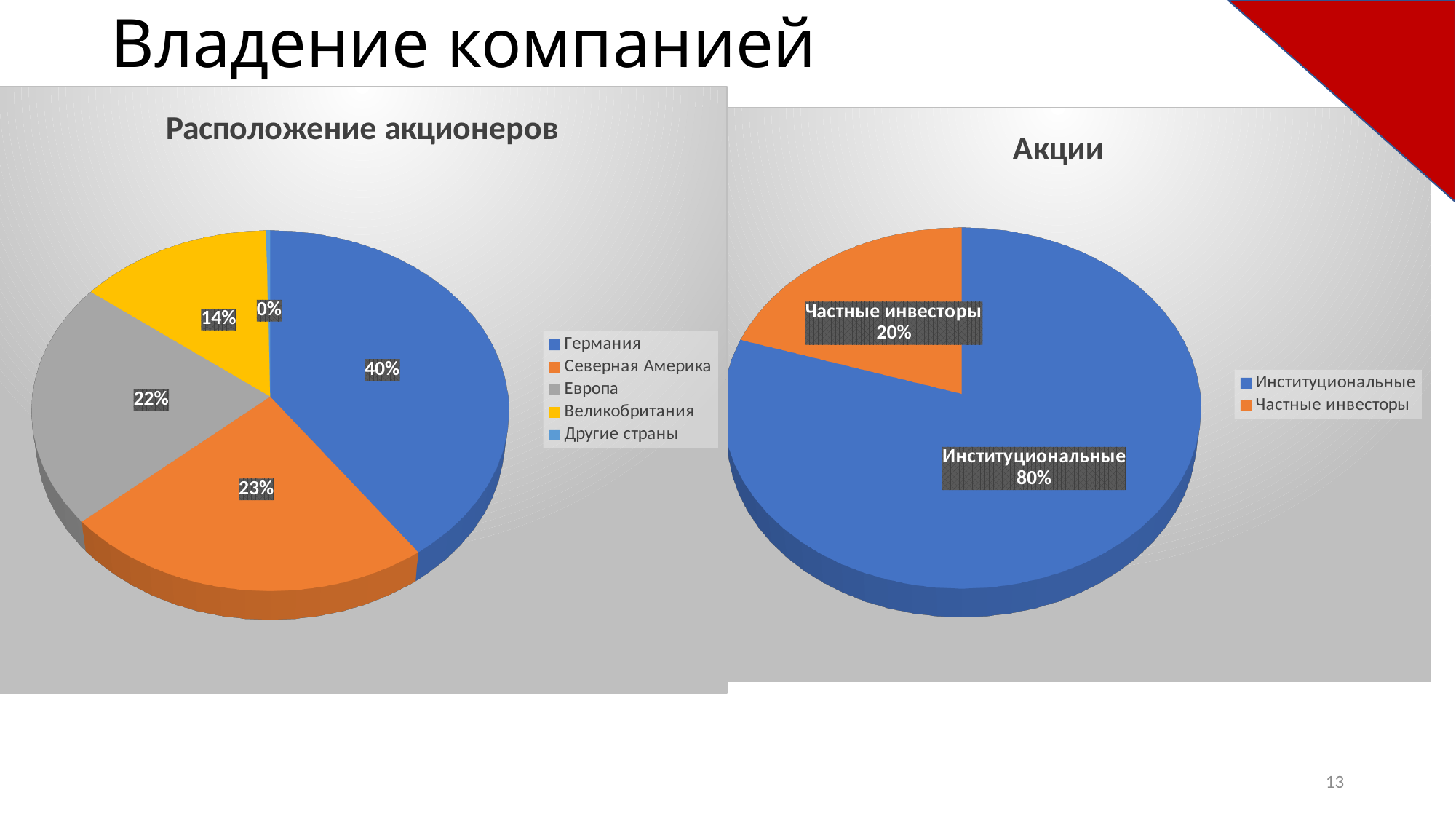
In the 'Расположение акционеров' chart, what share is shown for Великобритания? 14% In the 'Расположение акционеров' chart, what share is shown for Германия? 40% In the 'Акции' chart, which is larger: Институциональные or Частные инвесторы? Институциональные In the 'Акции' chart, what share is shown for Частные инвесторы? 20% In the 'Расположение акционеров' chart, which category has the largest slice? Германия In the 'Расположение акционеров' chart, what share is shown for Европа? 22% In the 'Расположение акционеров' chart, what is the difference between the shares of Германия and Великобритания? 26% In the 'Расположение акционеров' chart, how many categories does the legend list? 5 In the 'Расположение акционеров' chart, which category has the smallest slice? Другие страны In the 'Акции' chart, what share is shown for Институциональные? 80% In the 'Расположение акционеров' chart, what share is shown for Северная Америка? 23% What type of chart is the 'Акции' chart? Pie chart